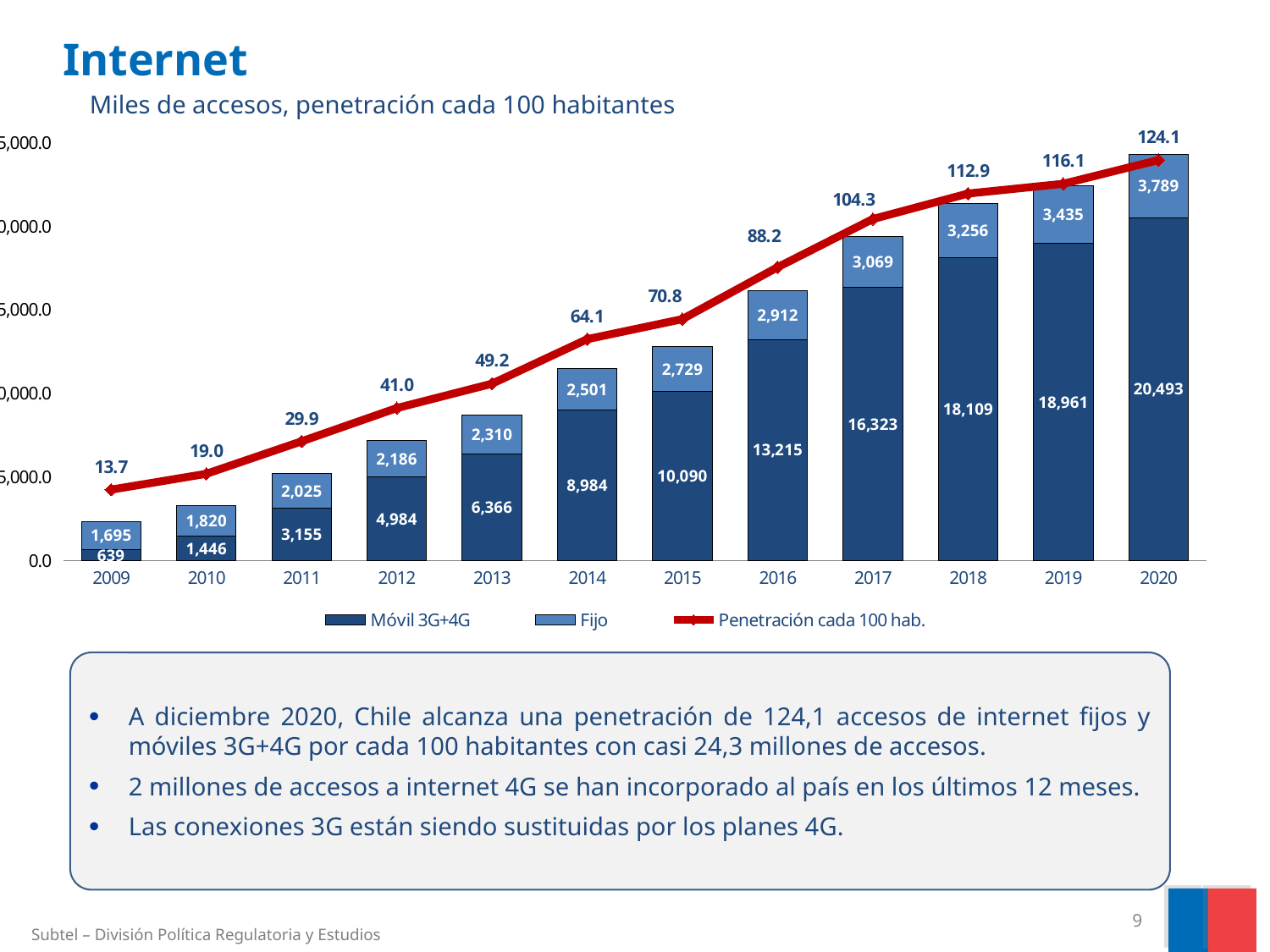
What is the Fijo value for 2015? 2,729 How many series does the legend list? 3 What is the Penetración cada 100 hab. value for 2017? 104.3 How many years are shown on the x axis? 12 Which year has the lowest Móvil 3G+4G value? 2009 What is the total of the stacked bar for 2020 (Móvil 3G+4G plus Fijo)? 24,282 What is the Móvil 3G+4G value for 2020? 20,493 What is the difference between the Móvil 3G+4G values for 2020 and 2019? 1,532 Does the Penetración cada 100 hab. line rise or fall from 2009 to 2020? Rises What kind of chart is this? Stacked bar chart with a line Which year has the highest Penetración cada 100 hab. value? 2020 Which is larger, the Fijo value for 2009 or the Móvil 3G+4G value for 2009? Fijo (1,695)